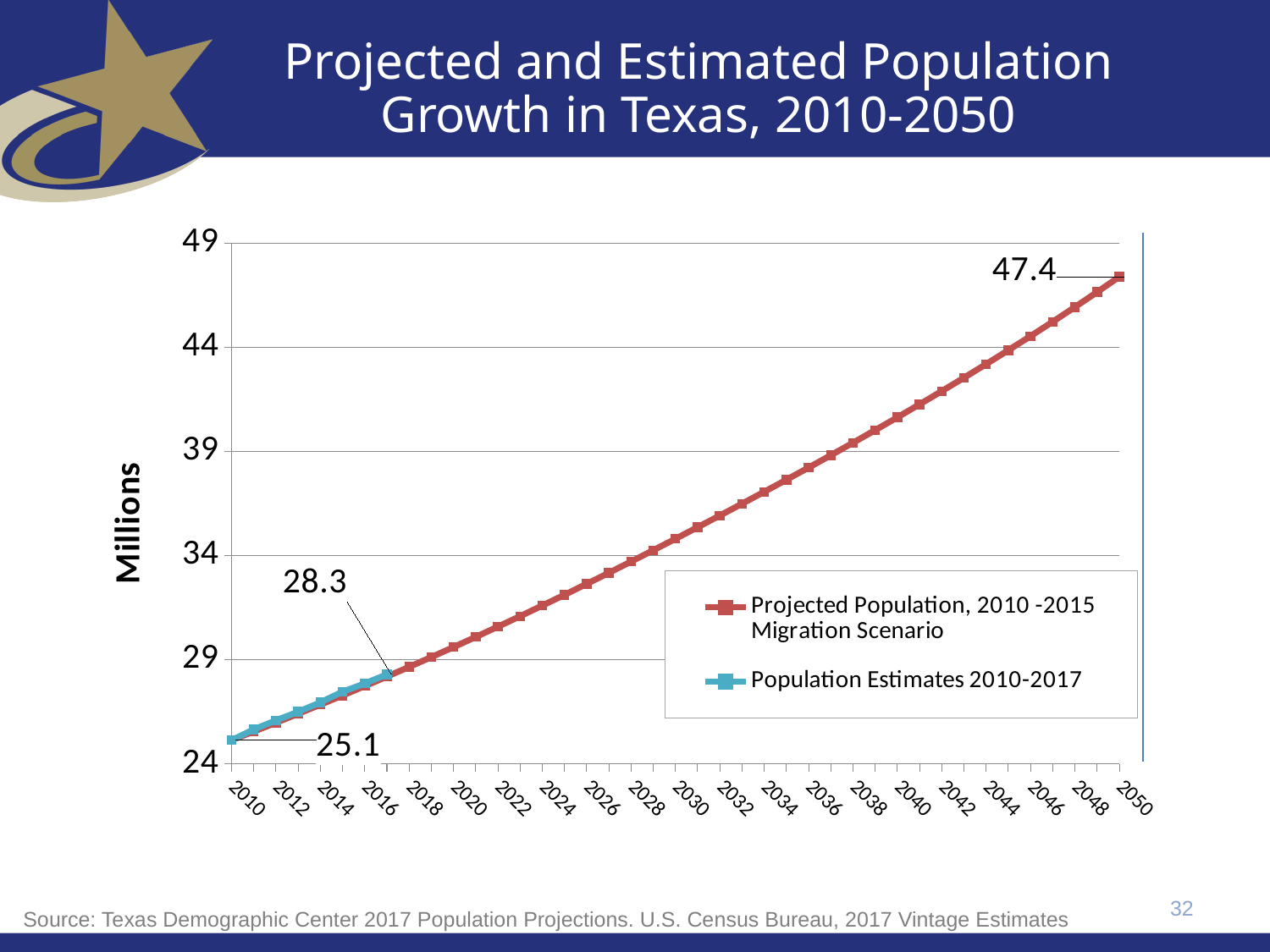
How many series does the legend list? 2 What is the difference between the 2050 projected value of 47.4 and the 2017 estimate of 28.3? 19.1 Do the population values rise or fall from 2010 to 2050? Rise What is the projected population value shown for 2050? 47.4 Is the projected population value for 2030 greater or less than 34? greater What is the label on the vertical axis of the chart? Millions What is the population value labeled at the start of the chart in 2010? 25.1 Is the projected population value for 2040 greater or less than 39? greater Is the projected population value for 2024 greater or less than 34? less What kind of chart is shown on the slide? Line chart What is the difference between the 2050 projected population (47.4) and the 2010 population (25.1)? 22.3 What is the value labeled at the end of the Population Estimates 2010-2017 series? 28.3